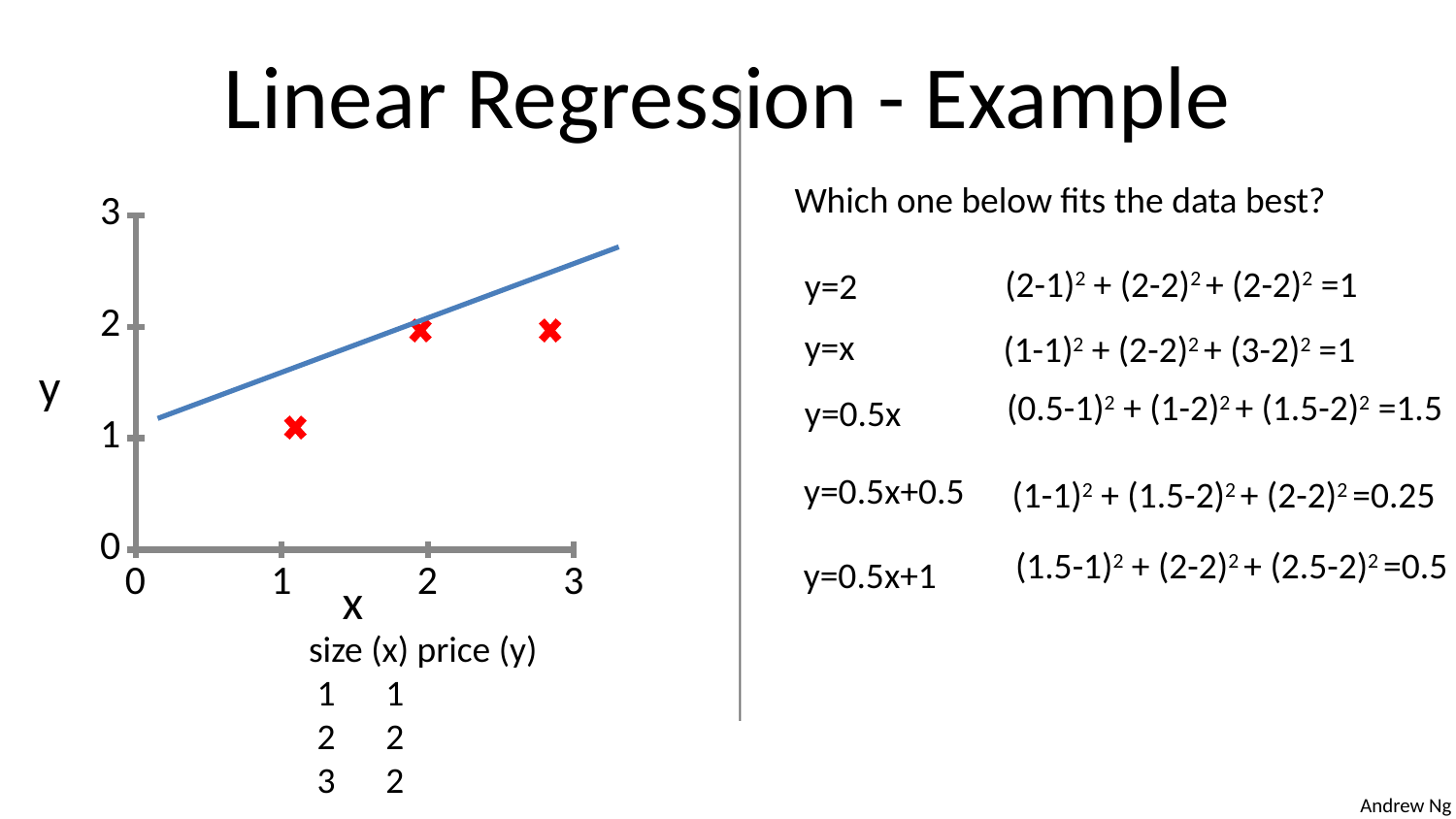
What is the price (y) value for size (x) = 3? 2 Is the y value of the point at x = 3 greater or less than 1? greater Is the price (y) for size (x) = 2 larger than the price (y) for size (x) = 1? yes What kind of chart is shown on the slide? scatter chart What is the label on the vertical axis of the chart? y What is the highest tick value shown on the x axis? 3 What is the difference between the price (y) at x = 2 and the price (y) at x = 1? 1 Which size (x) value has the lowest price (y)? 1 How many data points are plotted on the chart? 3 What is the price (y) value for size (x) = 2? 2 What is the price (y) value for size (x) = 1? 1 Do the plotted y values rise or fall as x increases from 1 to 2? rise